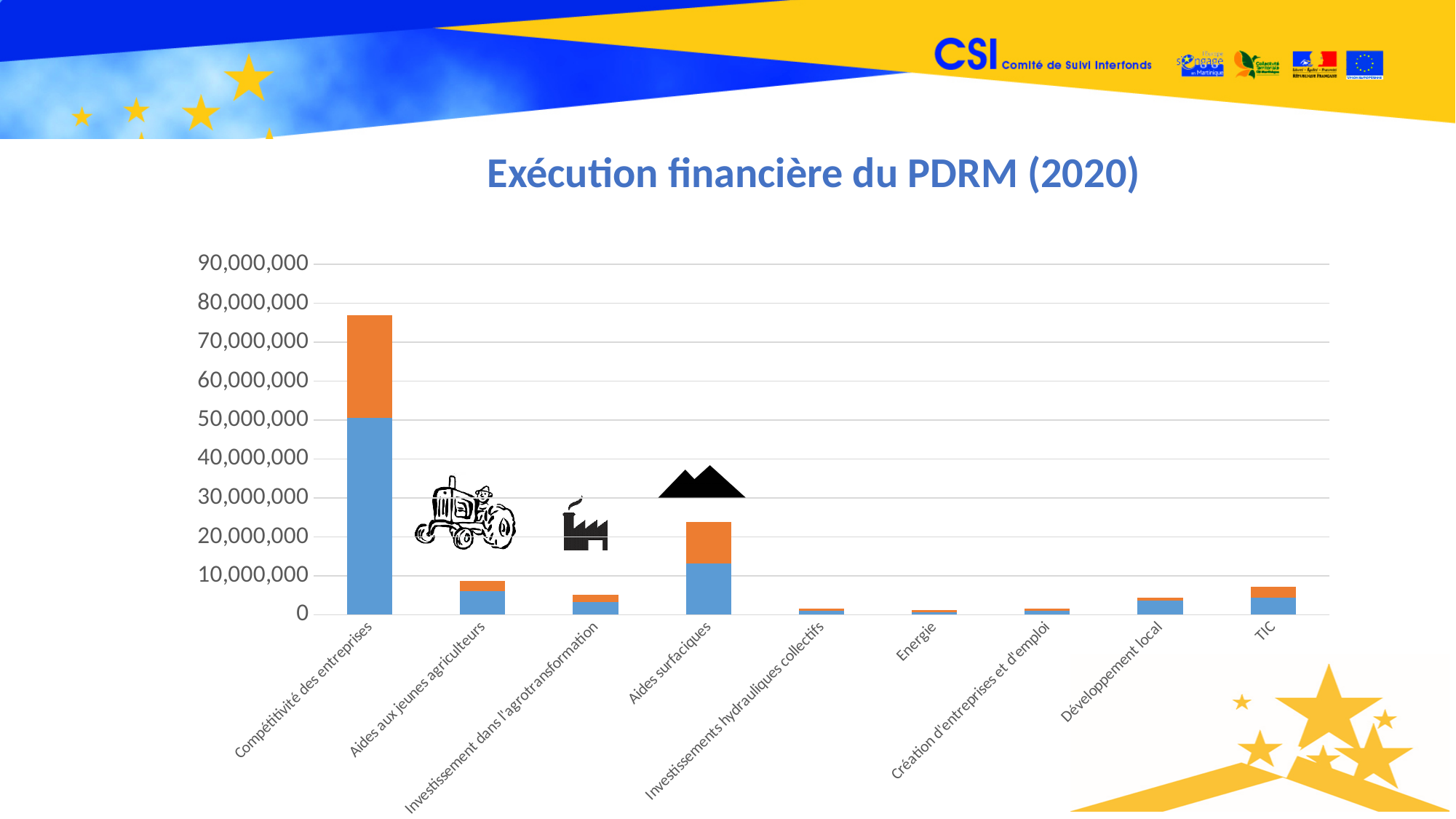
Is the total value for Aides surfaciques greater or less than 20,000,000? greater Which has the larger total bar, Aides surfaciques or Aides aux jeunes agriculteurs? Aides surfaciques What kind of chart is shown on the slide? Stacked bar chart Is the total value for Aides aux jeunes agriculteurs greater or less than 10,000,000? less Which category has the second highest total bar? Aides surfaciques How many categories are shown on the x axis of the chart? 9 Which has the larger total bar, TIC or Développement local? TIC Which category has the highest total bar? Compétitivité des entreprises Is the total value for Compétitivité des entreprises greater or less than 70,000,000? greater What is the title of the chart? Exécution financière du PDRM (2020) Which has the larger total bar, Compétitivité des entreprises or Energie? Compétitivité des entreprises